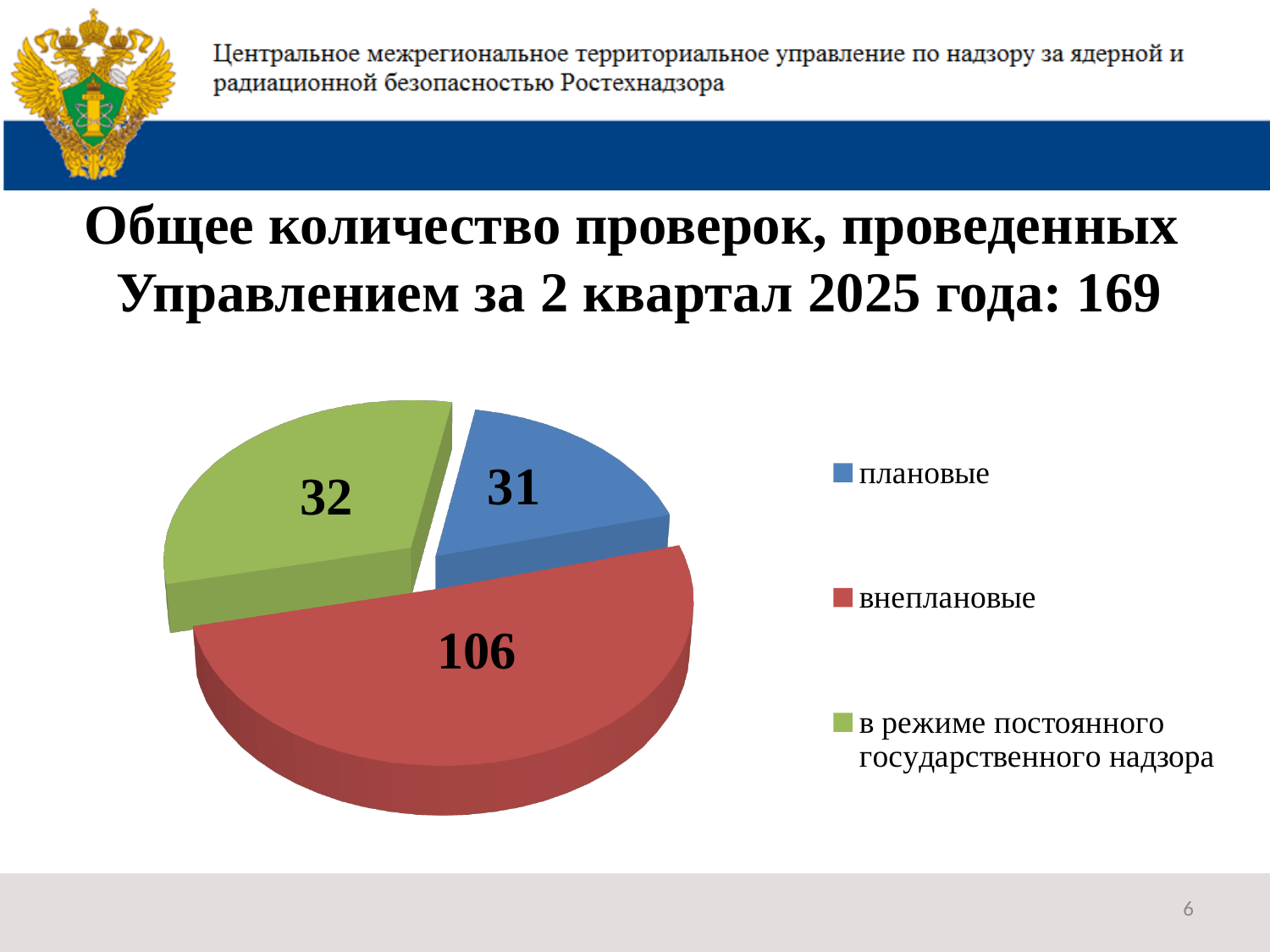
Which category has the smallest slice in the pie chart? плановые Which is larger: плановые or в режиме постоянного государственного надзора? в режиме постоянного государственного надзора What value is shown for the slice 'в режиме постоянного государственного надзора'? 32 How many slices does the pie chart have? 3 Which category has the largest slice in the pie chart? внеплановые What is the value of the внеплановые slice? 106 What total number of checks is stated in the slide title for the 2nd quarter of 2025? 169 What colour is the внеплановые slice? red What is the total of all slices in the pie chart? 169 What is the difference between the внеплановые and плановые values? 75 What type of chart is shown on the slide? pie chart How many checks are labelled as плановые in the pie chart? 31